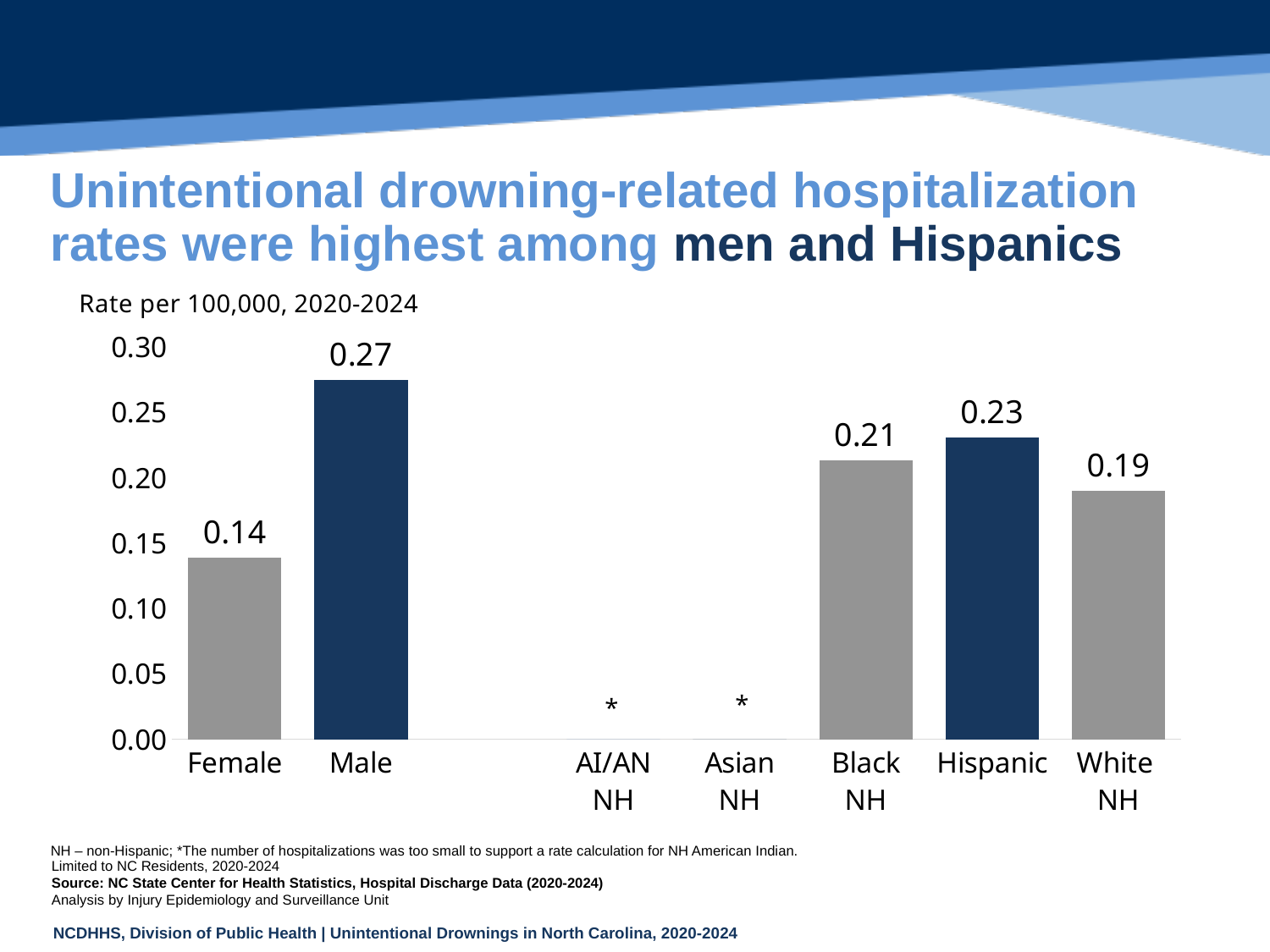
What is the rate per 100,000 for Female? 0.14 What is the rate per 100,000 for Male? 0.27 Which category has the highest rate? Male What kind of chart is shown on the slide? Bar chart How many categories are labeled on the x axis? 7 Among the categories with a plotted value, which has the lowest rate? Female What is the rate per 100,000 for Hispanic? 0.23 What is the difference between the Hispanic and Black NH rates? 0.02 Which categories are marked with an asterisk instead of a bar? AI/AN NH and Asian NH Which is larger, the rate for Black NH or the rate for White NH? Black NH What is the rate per 100,000 for White NH? 0.19 What is the difference between the Male and Female rates? 0.13